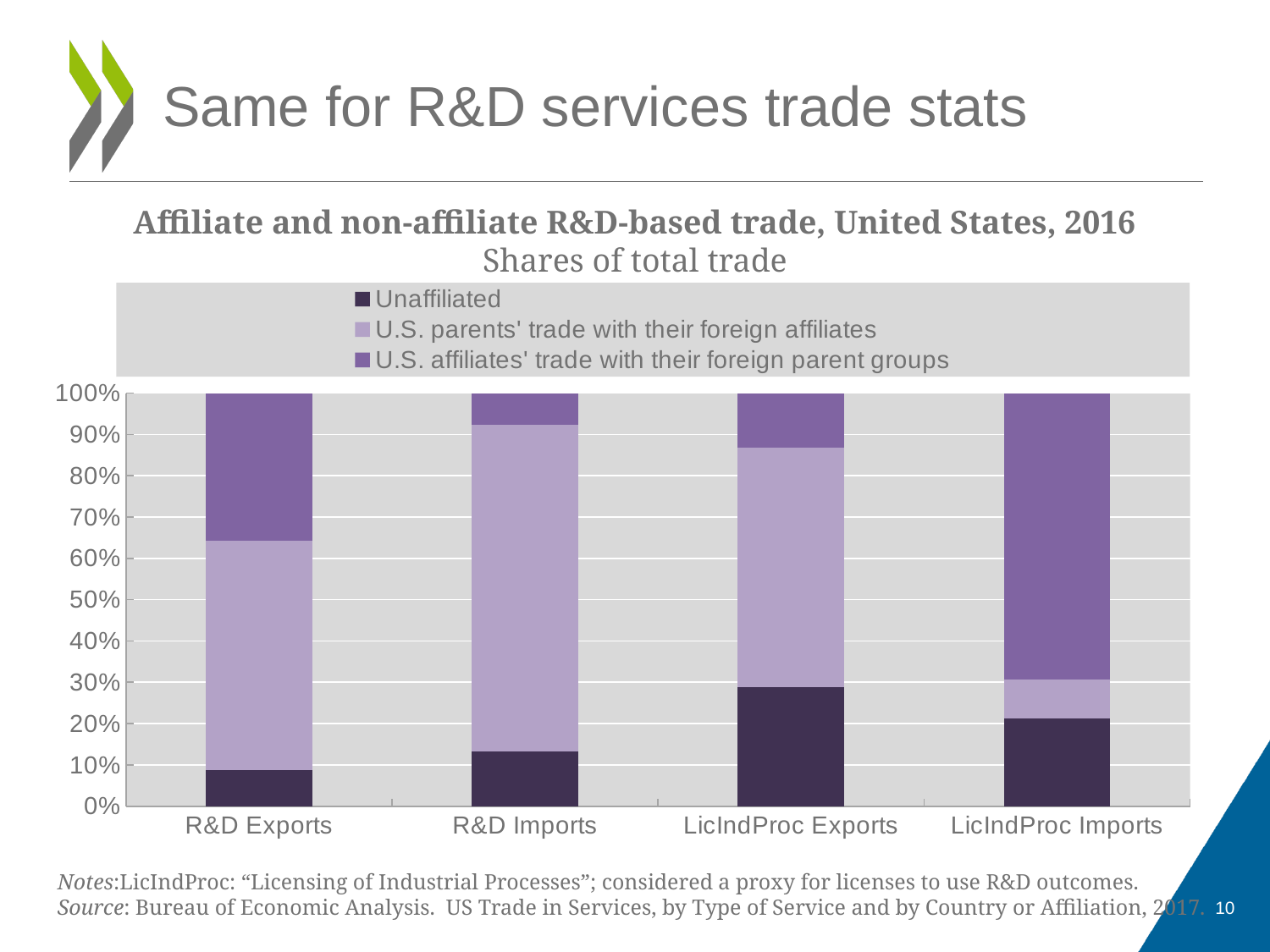
What kind of chart is shown on the slide? Stacked bar chart Which category has the largest share of U.S. parents' trade with their foreign affiliates? R&D Imports How many categories are shown on the x axis? 4 Which category has the largest Unaffiliated share? LicIndProc Exports Is the share of U.S. affiliates' trade with their foreign parent groups for LicIndProc Imports greater or less than 50%? greater Is the Unaffiliated share for R&D Exports greater or less than 20%? less What is the title of the chart? Affiliate and non-affiliate R&D-based trade, United States, 2016 Which has the larger Unaffiliated share, R&D Imports or LicIndProc Imports? LicIndProc Imports How many series does the legend list? 3 Which category has the smallest Unaffiliated share? R&D Exports Which category has the largest share of U.S. affiliates' trade with their foreign parent groups? LicIndProc Imports Is the Unaffiliated share for LicIndProc Exports greater or less than 20%? greater